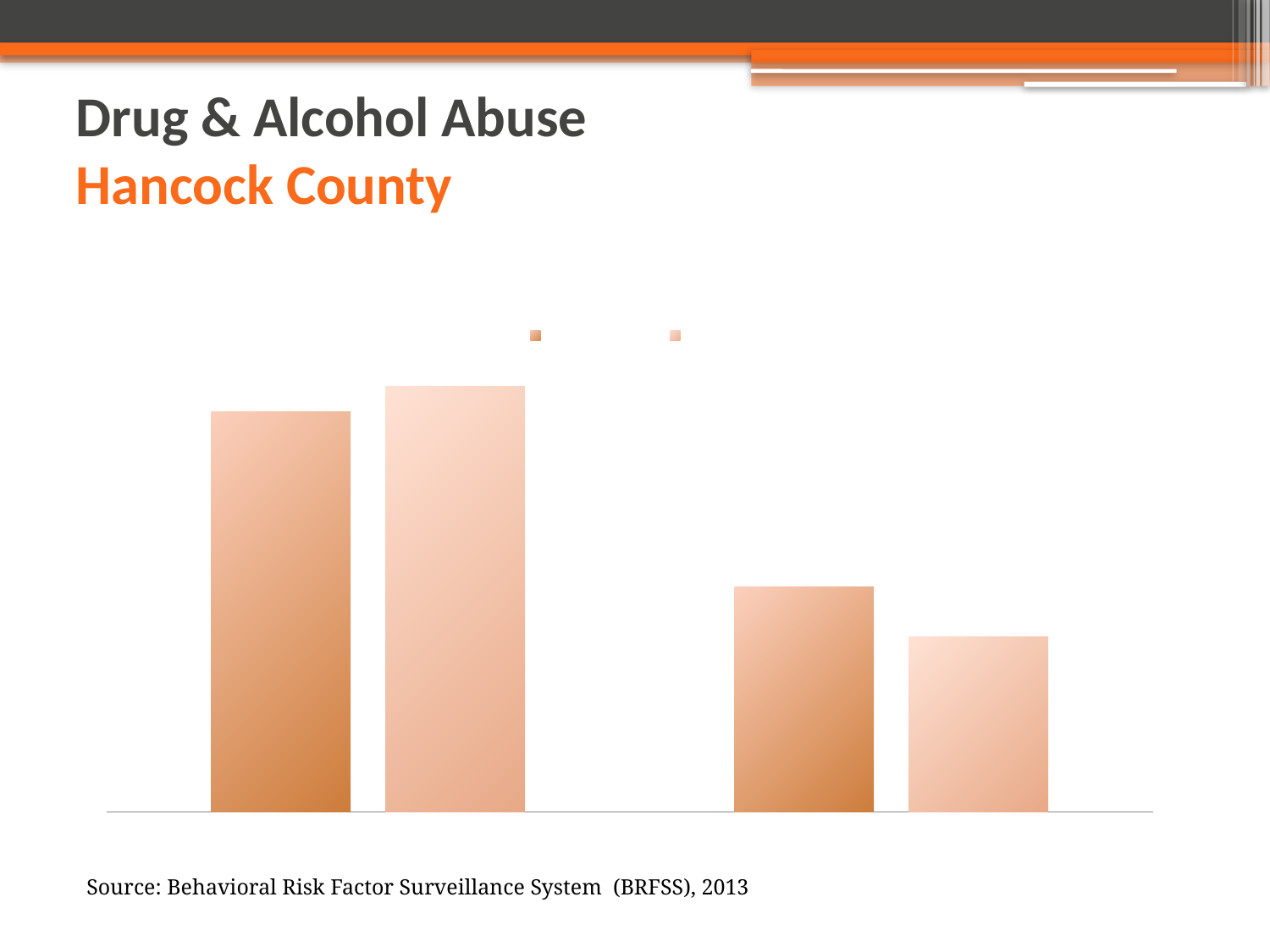
How many bars are plotted in the chart? 4 How many series does the chart's legend list? 2 How many groups of bars does the chart show? 2 Which bar is the tallest in the chart: the first, second, third or fourth from the left? second What colour are the bars in the chart? orange In the left group of bars, is the darker bar or the lighter bar taller? lighter bar What kind of chart is shown on the slide? bar chart What data source is cited below the chart? Behavioral Risk Factor Surveillance System (BRFSS), 2013 In the right group of bars, is the darker bar or the lighter bar taller? darker bar Which bar is the shortest in the chart: the first, second, third or fourth from the left? fourth Is the left group of bars taller or shorter than the right group of bars? taller